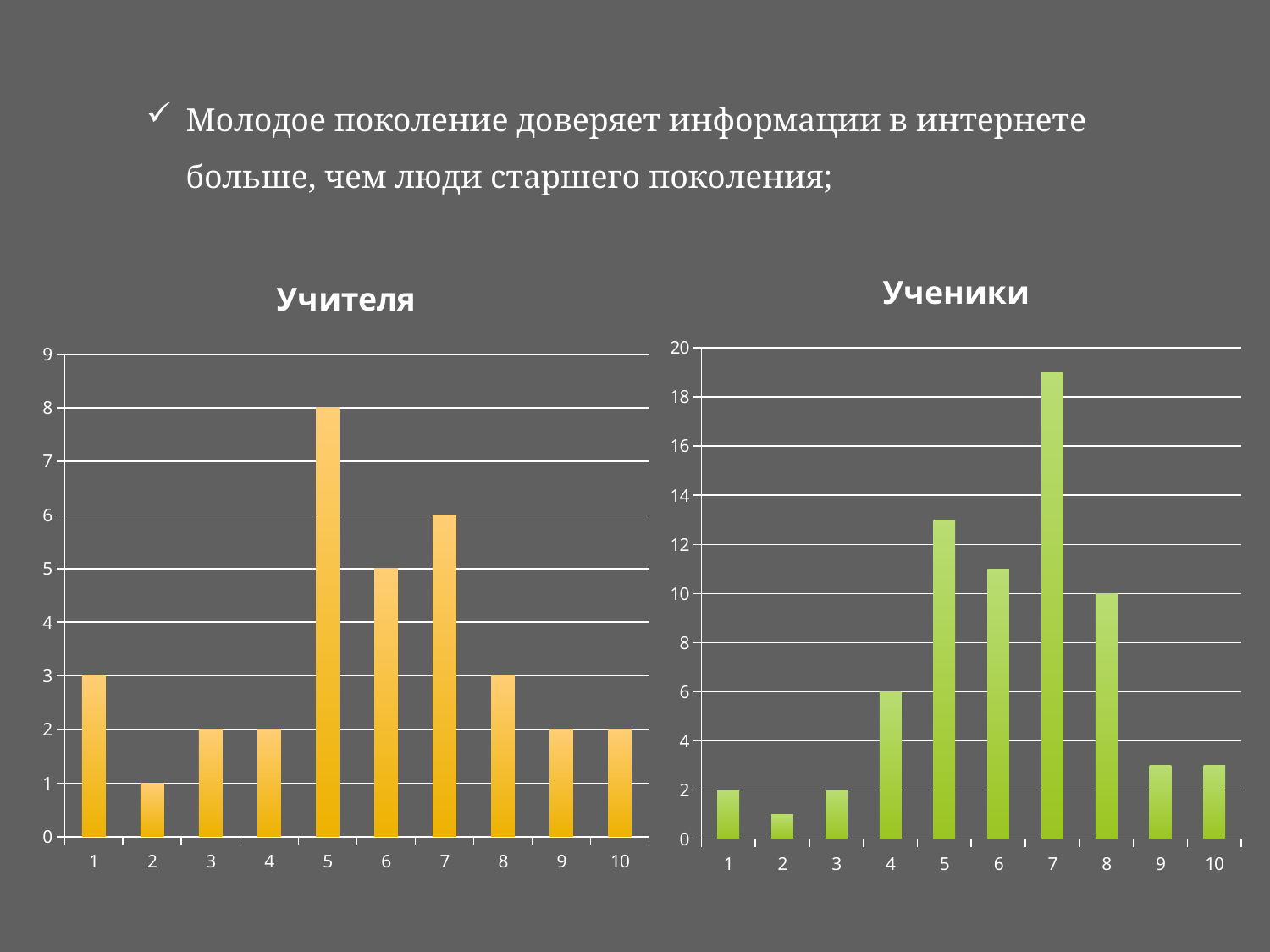
In the "Ученики" chart, which is larger, the value for category 6 or the value for category 8? category 6 In the "Учителя" chart, what is the difference between the values for category 5 and category 6? 3 In the "Учителя" chart, what is the value for category 7? 6 In the "Учителя" chart, how many categories are shown on the x axis? 10 In the "Ученики" chart, is the value for category 5 greater or less than 12? greater In the "Учителя" chart, what is the value for category 5? 8 In the "Ученики" chart, what is the value for category 8? 10 In the "Ученики" chart, which category has the highest value? 7 In the "Учителя" chart, which category has the lowest value? 2 In the "Учителя" chart, which category has the highest value? 5 In the "Ученики" chart, what is the value for category 4? 6 What type of chart is the "Учителя" chart? bar chart